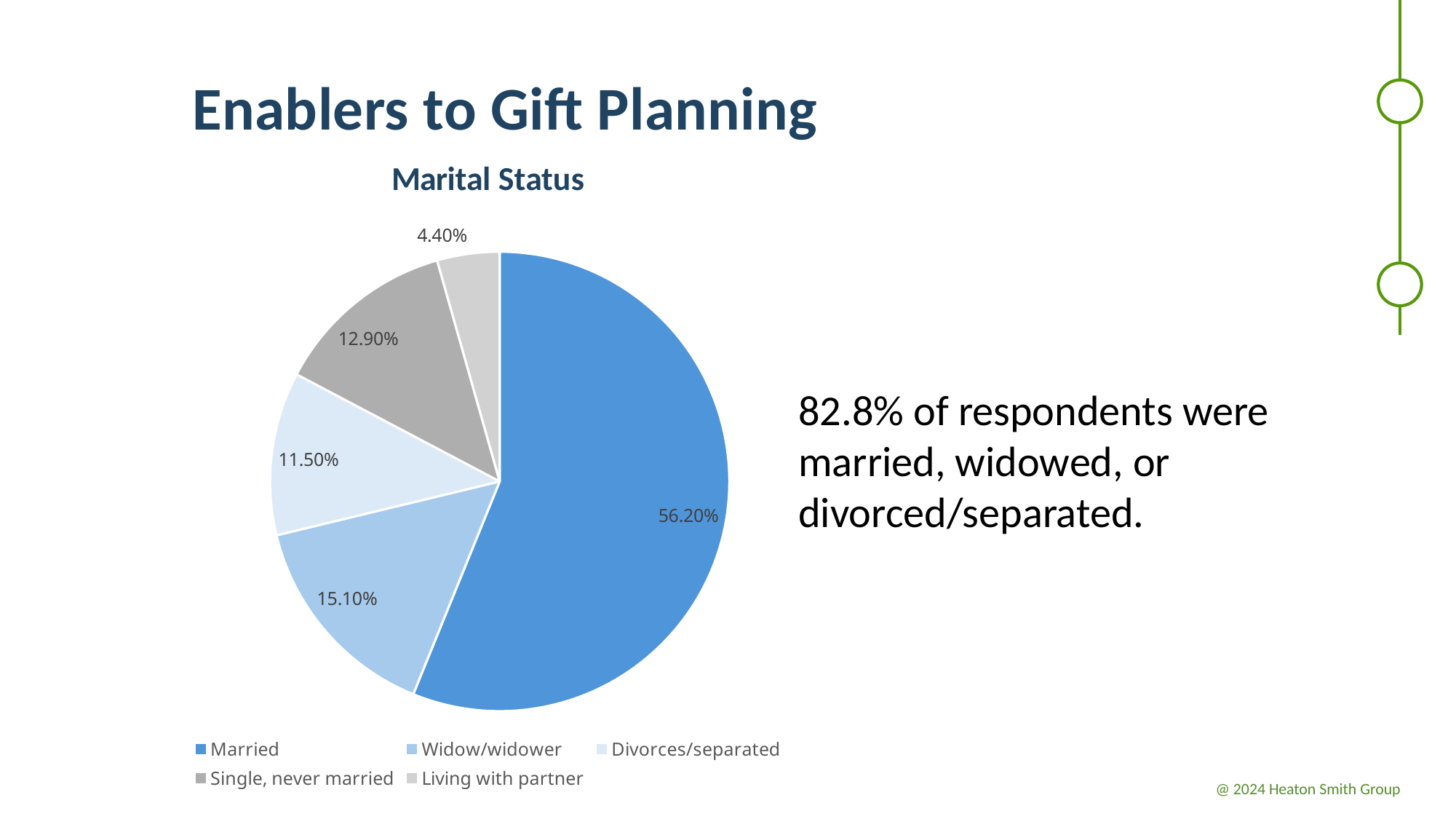
How many categories does the pie chart show? 5 What percentage of respondents were Married? 56.20% What percentage of respondents were Single, never married? 12.90% What is the difference between the Married share and the Widow/widower share? 41.10% Which is larger, the share for Widow/widower or the share for Single, never married? Widow/widower What kind of chart is shown on the slide? pie chart What percentage of respondents were Living with partner? 4.40% What percentage of respondents were Widow/widower? 15.10% Which marital status category has the smallest share? Living with partner What is the title of the chart? Marital Status Which marital status category has the largest share? Married What percentage of respondents were Divorces/separated? 11.50%